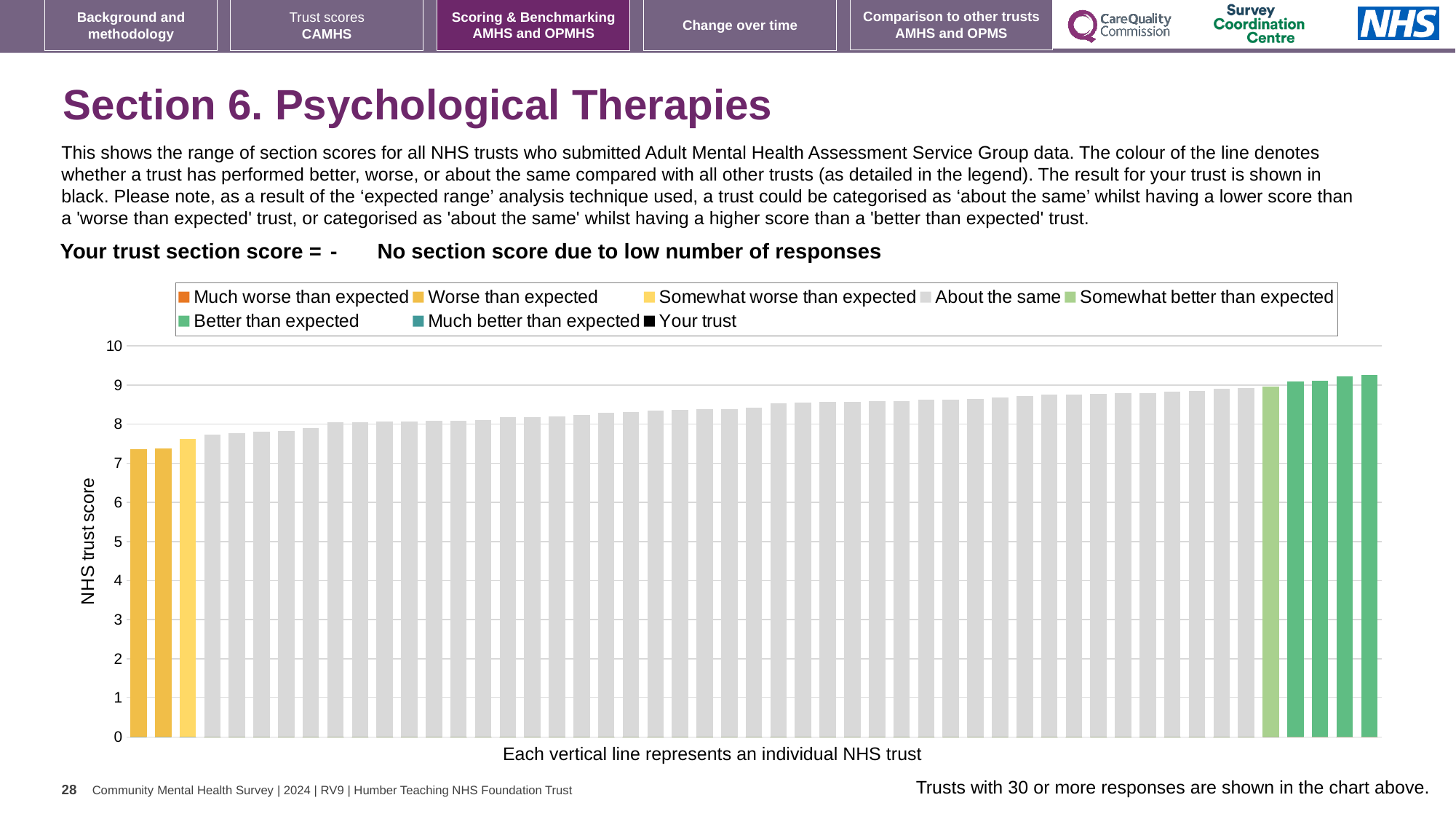
Is the value of the rightmost bar greater or less than 9? greater How many entries does the chart legend list? 8 What kind of chart is shown on the slide? bar chart How many bars are coloured as 'Worse than expected' (orange-yellow)? 2 Which legend category do the shortest bars in the chart belong to? Worse than expected How many bars are coloured as 'Better than expected' (dark green)? 4 Is the value of the tallest bar greater or less than 10? less Is the value of the leftmost bar greater or less than 7? greater Which legend category do the tallest bars in the chart belong to? Better than expected Do the bar values rise or fall from left to right along the x axis? rise What is the label on the vertical axis of the chart? NHS trust score